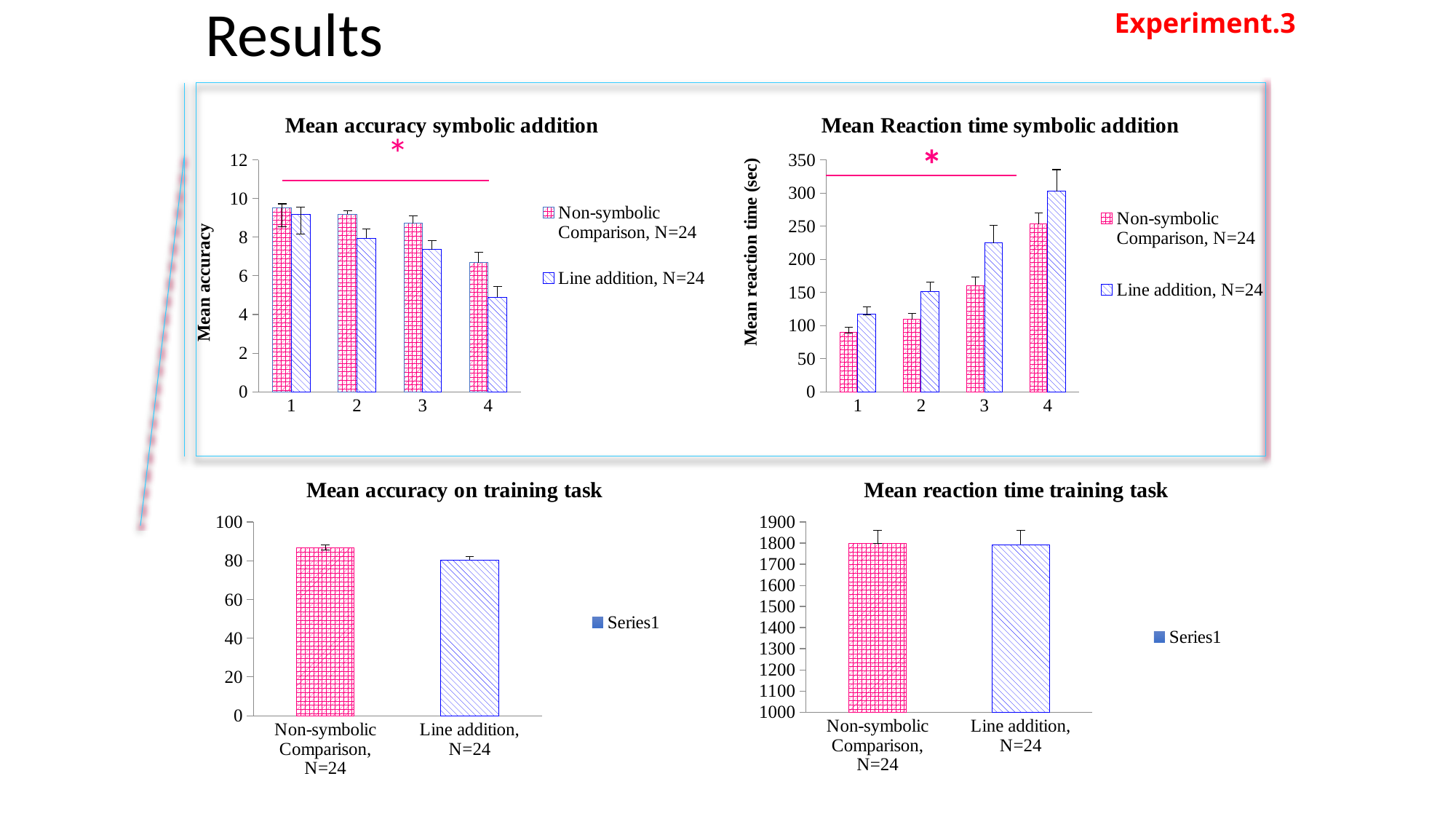
In the "Mean Reaction time symbolic addition" chart, do the values for Non-symbolic Comparison, N=24 rise or fall from category 1 to category 4? rise What is the legend entry shown in the "Mean reaction time training task" chart? Series1 In the "Mean accuracy symbolic addition" chart, how many categories are shown on the x axis? 4 In the "Mean accuracy symbolic addition" chart, how many series does the legend list? 2 What kind of chart is "Mean accuracy symbolic addition"? bar chart In the "Mean accuracy symbolic addition" chart, is the value for Line addition, N=24 at category 4 greater or less than 6? less In the "Mean accuracy on training task" chart, which category has the larger value: Non-symbolic Comparison, N=24 or Line addition, N=24? Non-symbolic Comparison, N=24 In the "Mean reaction time training task" chart, is the value for Non-symbolic Comparison, N=24 greater or less than 1700? greater In the "Mean Reaction time symbolic addition" chart, at which category is the value for Line addition, N=24 highest? 4 In the "Mean Reaction time symbolic addition" chart, is the value for Line addition, N=24 at category 4 greater or less than 250? greater In the "Mean Reaction time symbolic addition" chart, at category 3, which series has the larger value: Non-symbolic Comparison, N=24 or Line addition, N=24? Line addition, N=24 In the "Mean accuracy symbolic addition" chart, do the values for Line addition, N=24 rise or fall from category 1 to category 4? fall